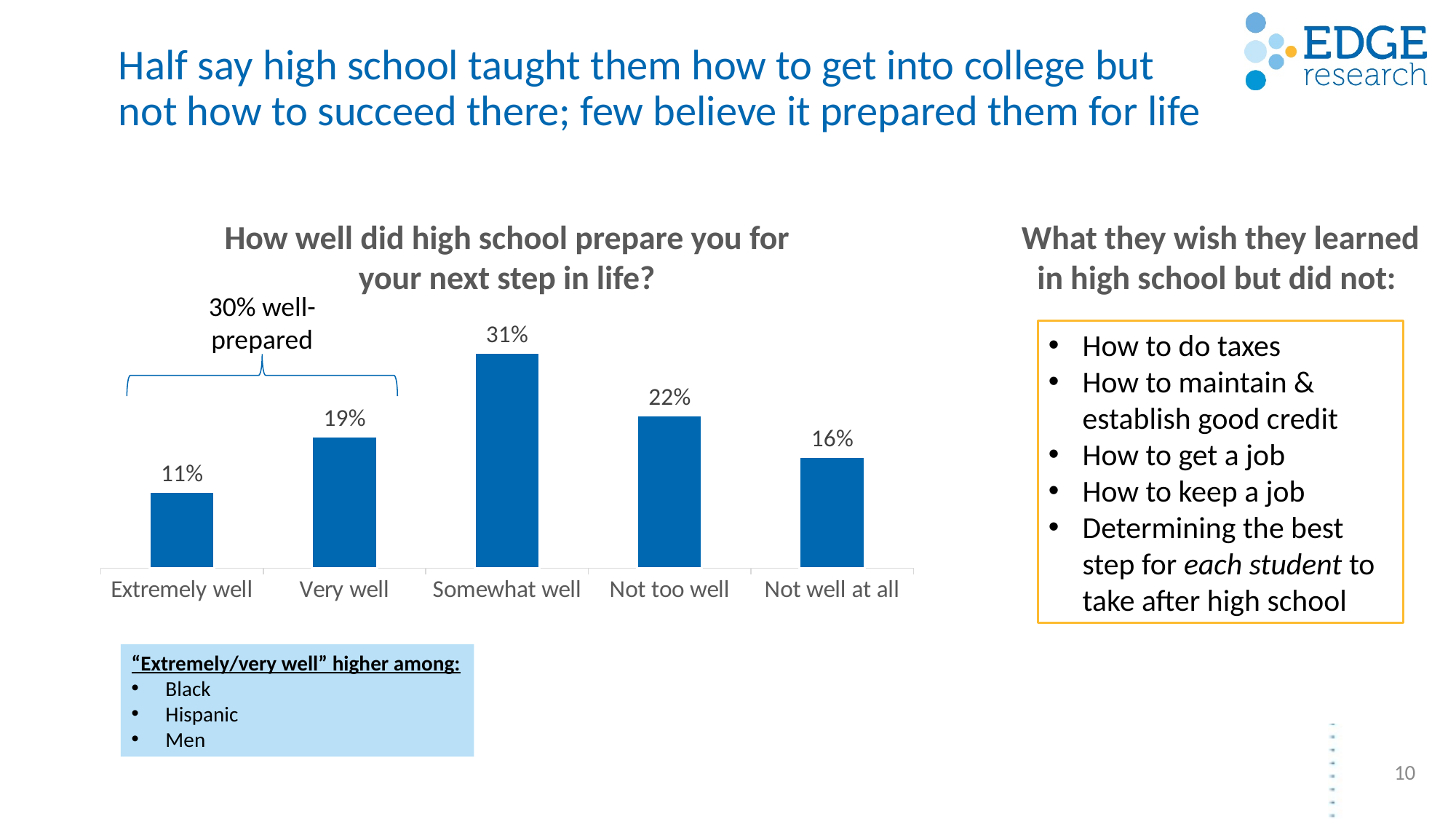
What is the value for "Not well at all"? 16% Which category has the lowest value? Extremely well What colour are the bars in the chart? Blue What kind of chart is shown? Bar chart What is the value for "Extremely well"? 11% What percentage said high school prepared them "Somewhat well" for their next step in life? 31% What is the combined total of "Extremely well" and "Very well", as labelled by the bracket above the chart? 30% How many categories are shown on the x axis? 5 Which is larger, the value for "Very well" or the value for "Not too well"? Not too well What is the difference between the "Not too well" and "Not well at all" values? 6% Which category has the highest value? Somewhat well What is the title of the chart? How well did high school prepare you for your next step in life?